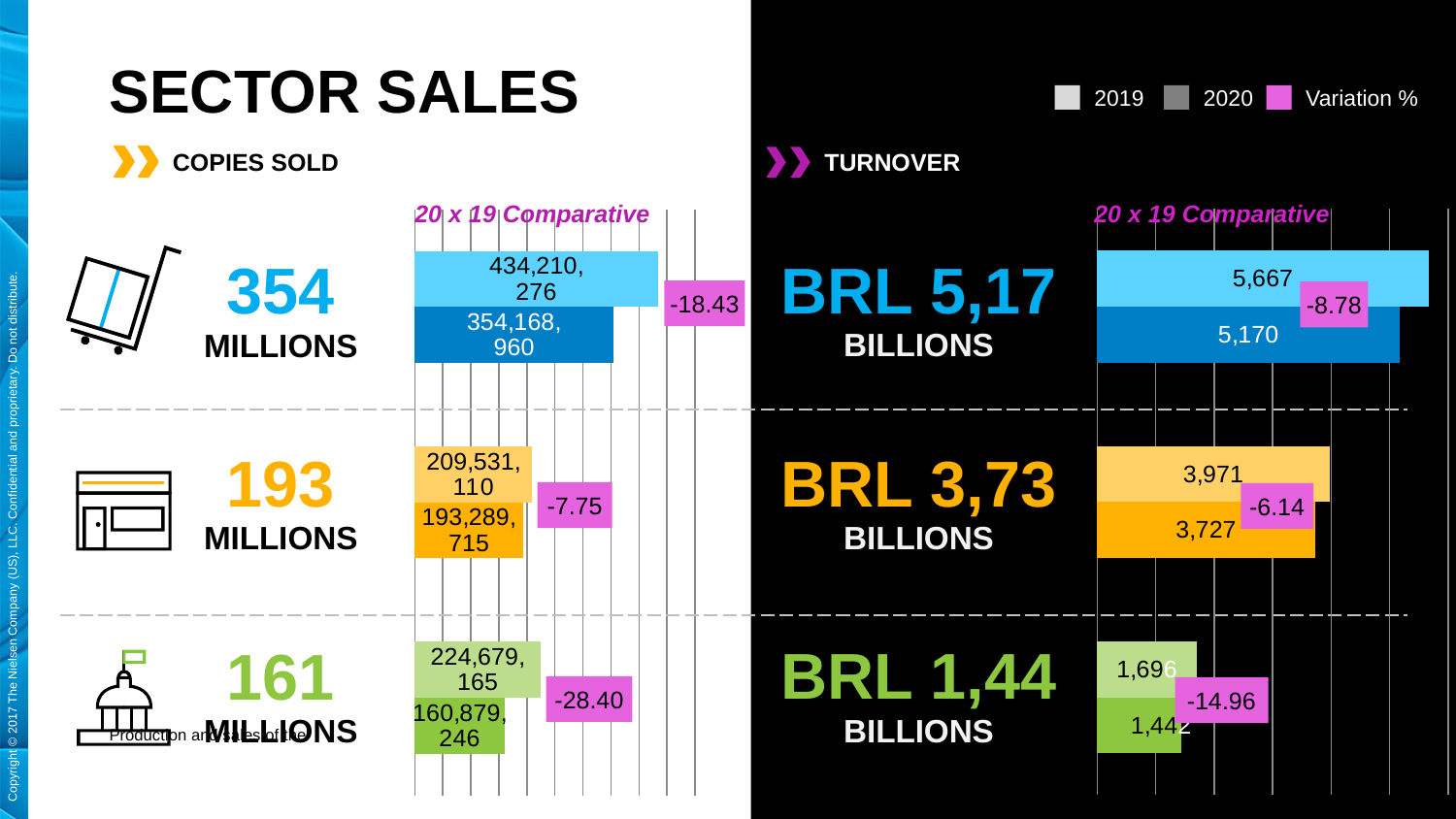
In the top Turnover chart, what is the value for 2019? 5,667 In the middle Turnover chart, what is the difference between the 2019 and 2020 values? 244 In the bottom Copies Sold chart, what is the Variation % shown? -28.40 What kind of chart is used for the 20 x 19 Comparative charts on this slide? Bar chart How many series does the legend at the top right of the slide list? 3 In the bottom Copies Sold chart, what is the difference between the 2019 and 2020 values? 63,799,919 In the middle Copies Sold chart, what is the value for 2020? 193,289,715 In the top Turnover chart, what is the difference between the 2019 and 2020 values? 497 In the middle Turnover chart, which is larger, the 2019 value or the 2020 value? 2019 In the top Copies Sold chart, what is the Variation % shown? -18.43 In the top Copies Sold chart, what is the value for 2020? 354,168,960 In the top Copies Sold chart, what is the value for 2019? 434,210,276